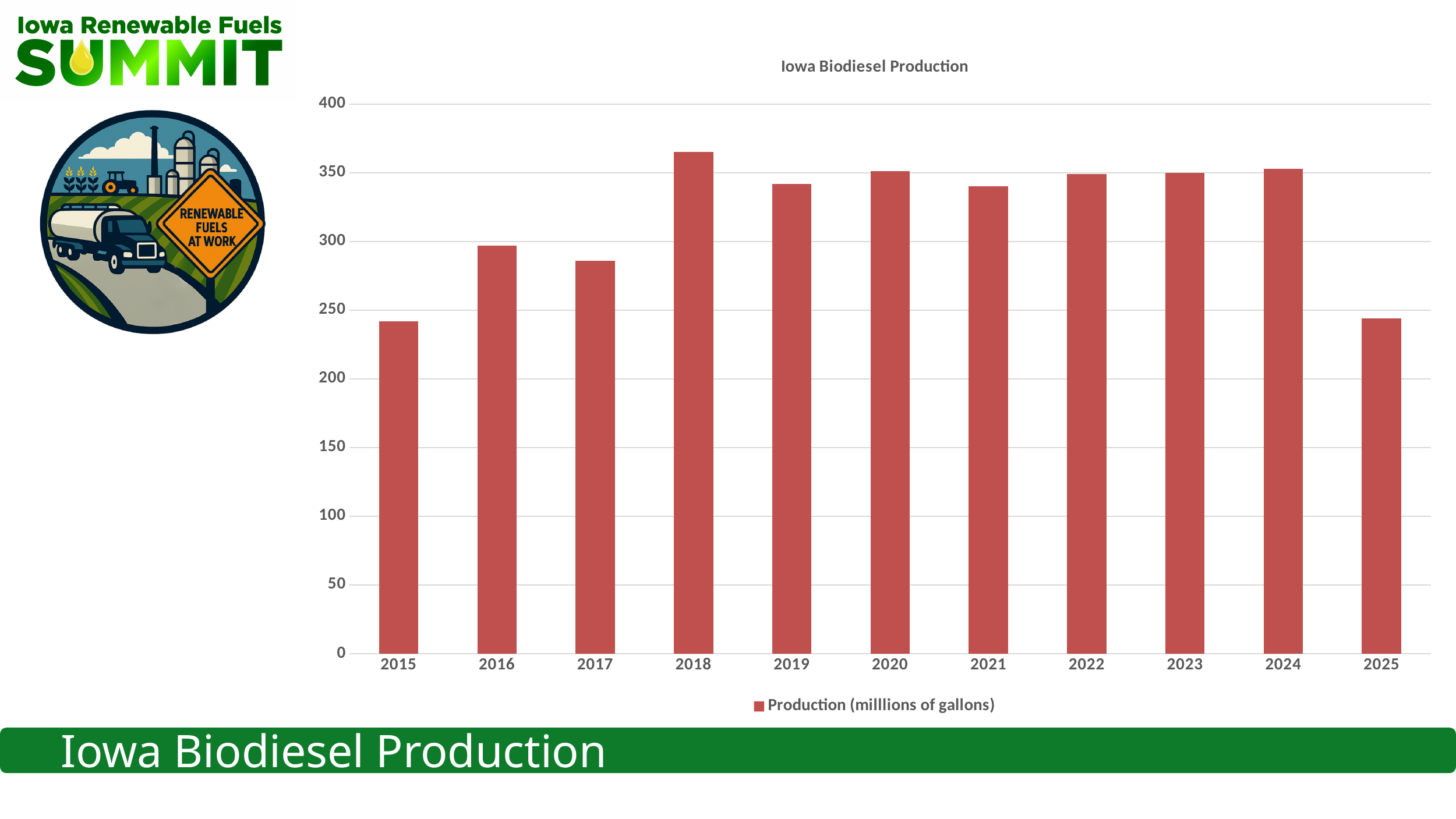
Is the value for 2018 greater or less than 350? greater How many series does the chart's legend list? 1 Is the value for 2015 greater or less than 250? less What is the series name shown in the chart's legend? Production (milllions of gallons) Is the value for 2025 greater or less than 300? less Which year has the highest biodiesel production in the chart? 2018 Which year has the larger production value, 2016 or 2017? 2016 How many years are plotted on the x axis of the chart? 11 Which year has the larger production value, 2024 or 2025? 2024 What kind of chart is shown on the slide? bar chart